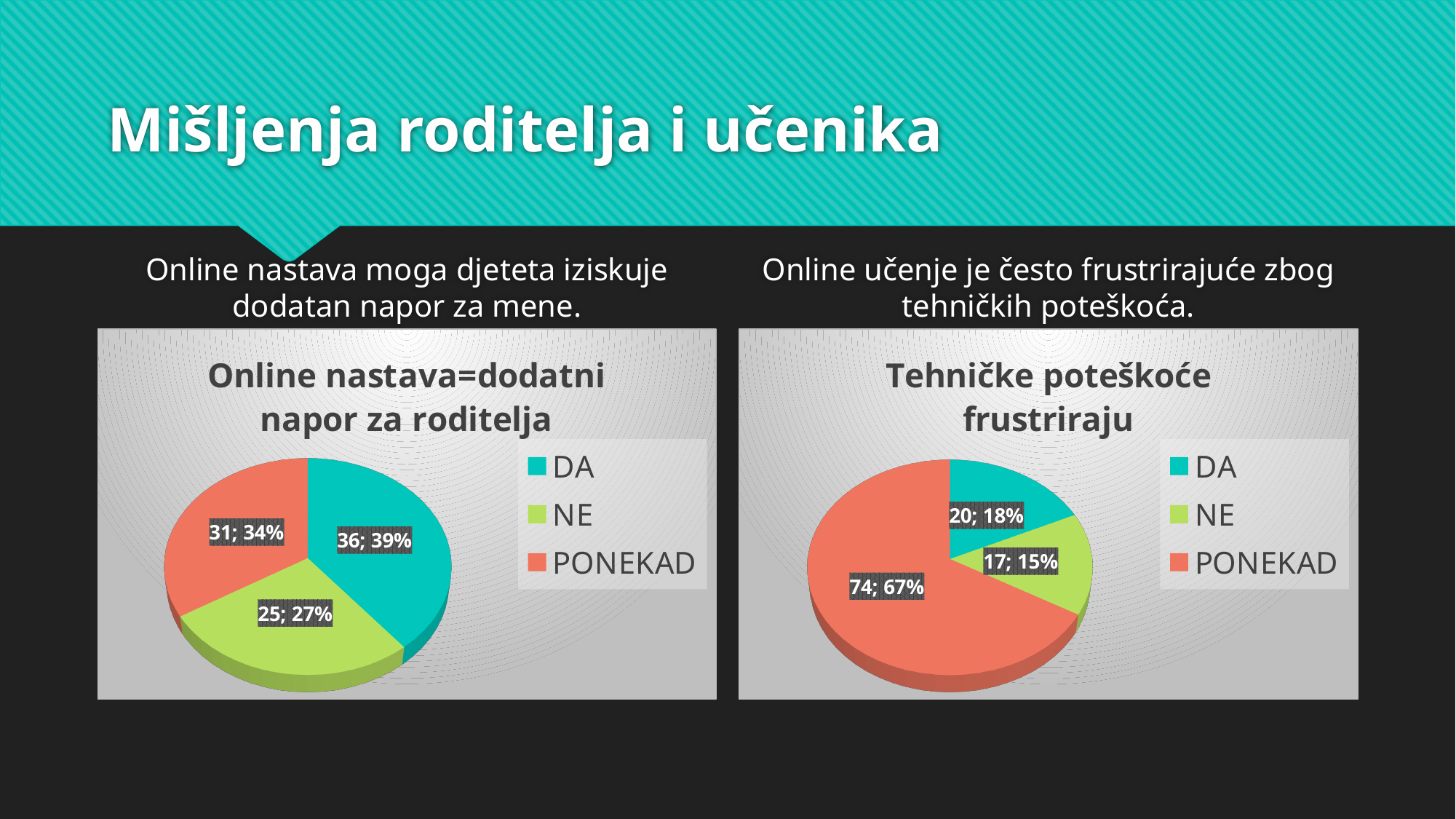
How many categories does the legend of the chart titled "Online nastava=dodatni napor za roditelja" list? 3 In the chart titled "Online nastava=dodatni napor za roditelja", which category has the smallest slice? NE In the chart titled "Tehničke poteškoće frustriraju", what percentage share does DA have? 18% In the chart titled "Online nastava=dodatni napor za roditelja", what percentage share does NE have? 27% In the chart titled "Tehničke poteškoće frustriraju", which is larger, DA or NE? DA In the chart titled "Online nastava=dodatni napor za roditelja", which category has the largest slice? DA In the chart titled "Online nastava=dodatni napor za roditelja", what is the count for DA? 36 In the chart titled "Tehničke poteškoće frustriraju", what is the count for PONEKAD? 74 What type of chart is used in the chart titled "Tehničke poteškoće frustriraju"? Pie chart In the chart titled "Tehničke poteškoće frustriraju", which category has the largest slice? PONEKAD In the chart titled "Online nastava=dodatni napor za roditelja", what is the difference between the counts for DA and PONEKAD? 5 In the chart titled "Tehničke poteškoće frustriraju", what is the difference between the counts for PONEKAD and NE? 57